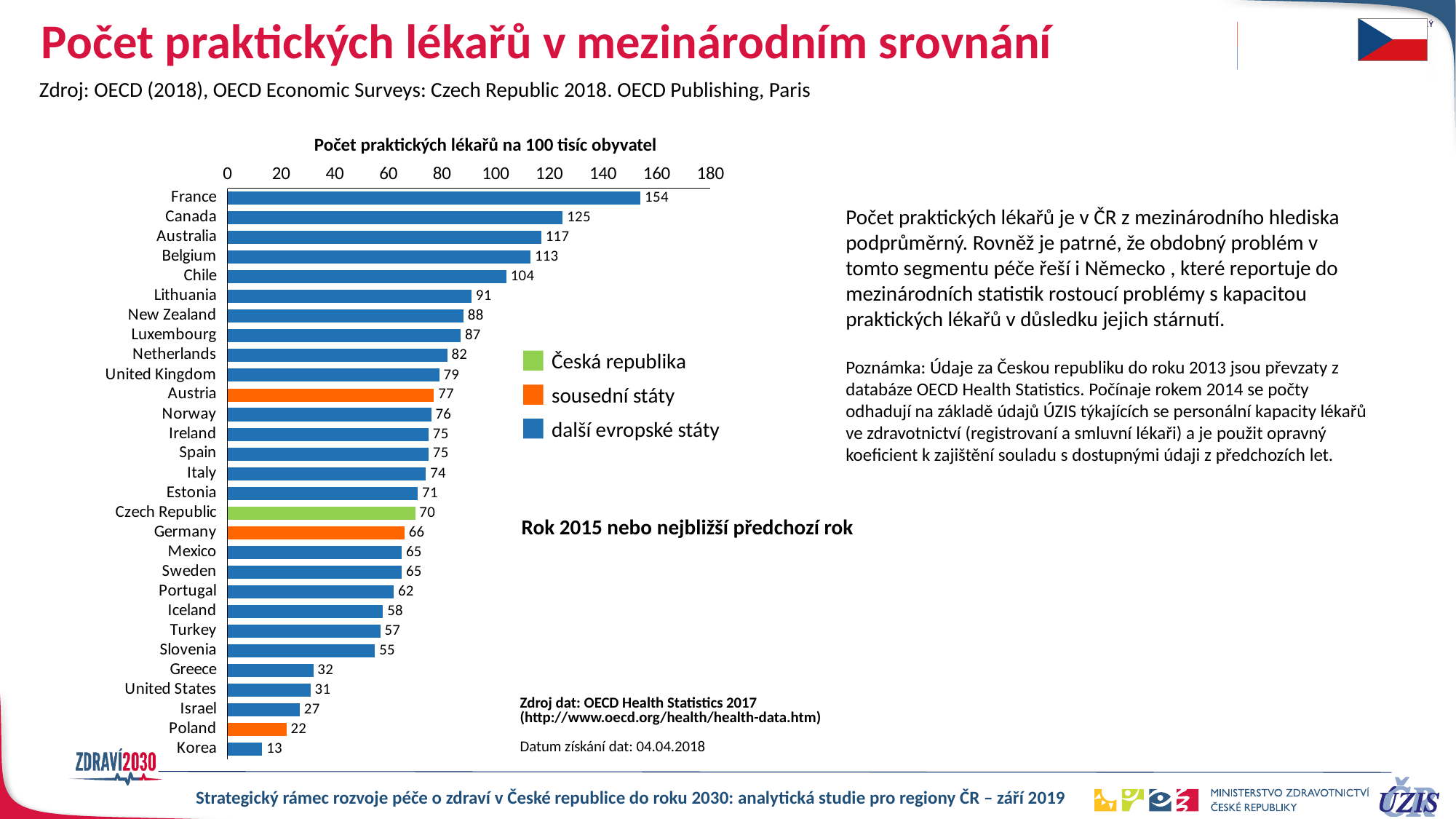
What type of chart is shown on the slide? bar chart How many countries are shown in the chart? 29 What is the value for Germany? 66 What is the difference between the values for France and Canada? 29 What is the value for France? 154 What is the value for the Czech Republic? 70 Which country has the lowest value in the chart? Korea Which has a higher value, Austria or Poland? Austria How many entries does the legend list? 3 What is the title of the chart? Počet praktických lékařů na 100 tisíc obyvatel Which legend entry is shown in green? Česká republika Which country has the highest number of practical doctors per 100 thousand inhabitants? France